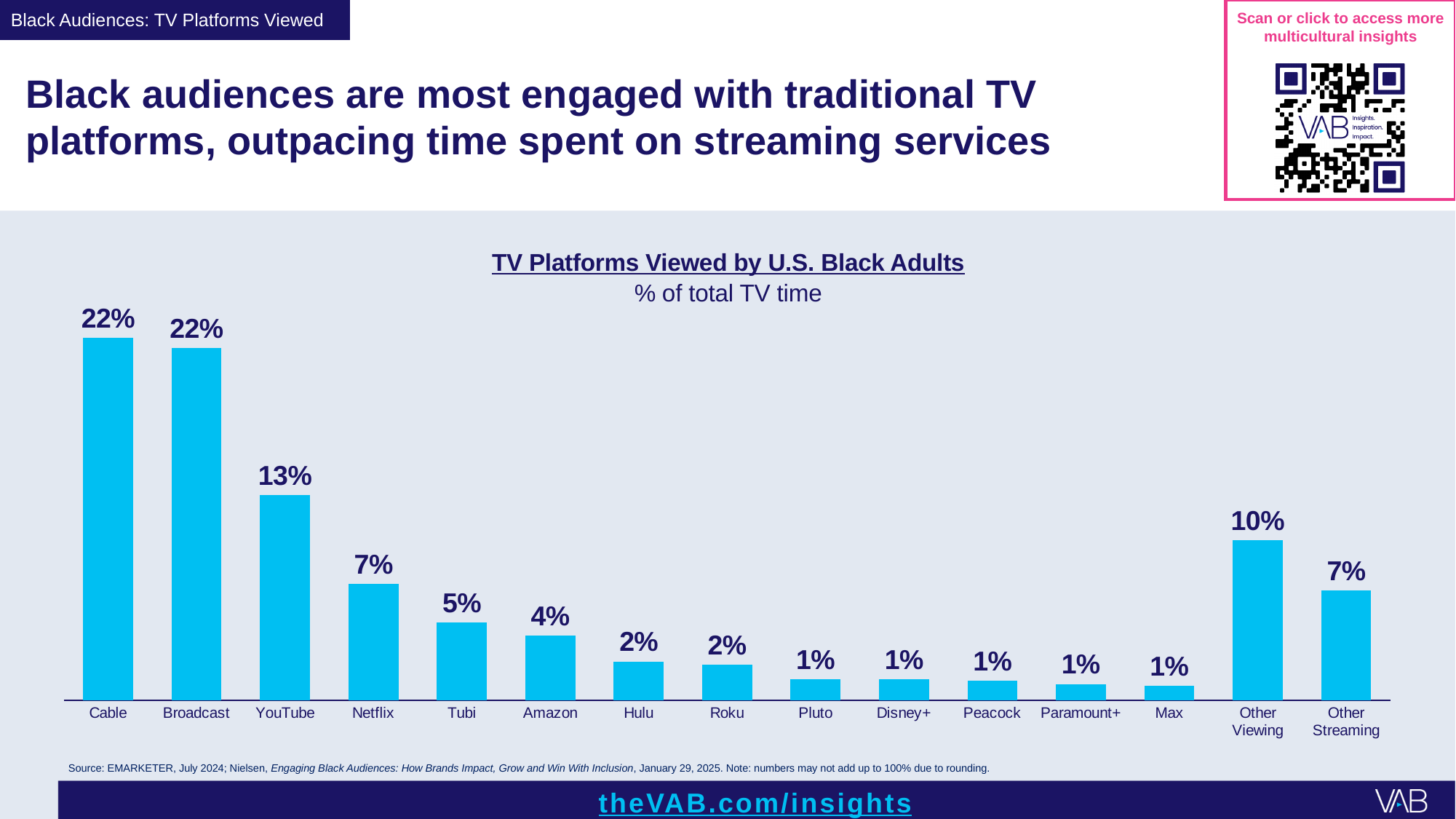
What type of chart is used to show TV Platforms Viewed by U.S. Black Adults? Bar chart Which two platforms share the highest value in the chart? Cable and Broadcast What is the value shown for Tubi? 5% What is the value shown for Netflix? 7% What is the difference between the values for YouTube and Netflix? 6% What share of total TV time is shown for Other Viewing? 10% Which has a larger value, Amazon or Hulu? Amazon What is the difference between the values for Cable and Other Viewing? 12% What value is shown for Cable? 22% How many platform categories are shown on the x axis of the chart? 15 What is the subtitle shown under the chart title? % of total TV time What percentage of total TV time does YouTube account for in the TV Platforms Viewed by U.S. Black Adults chart? 13%